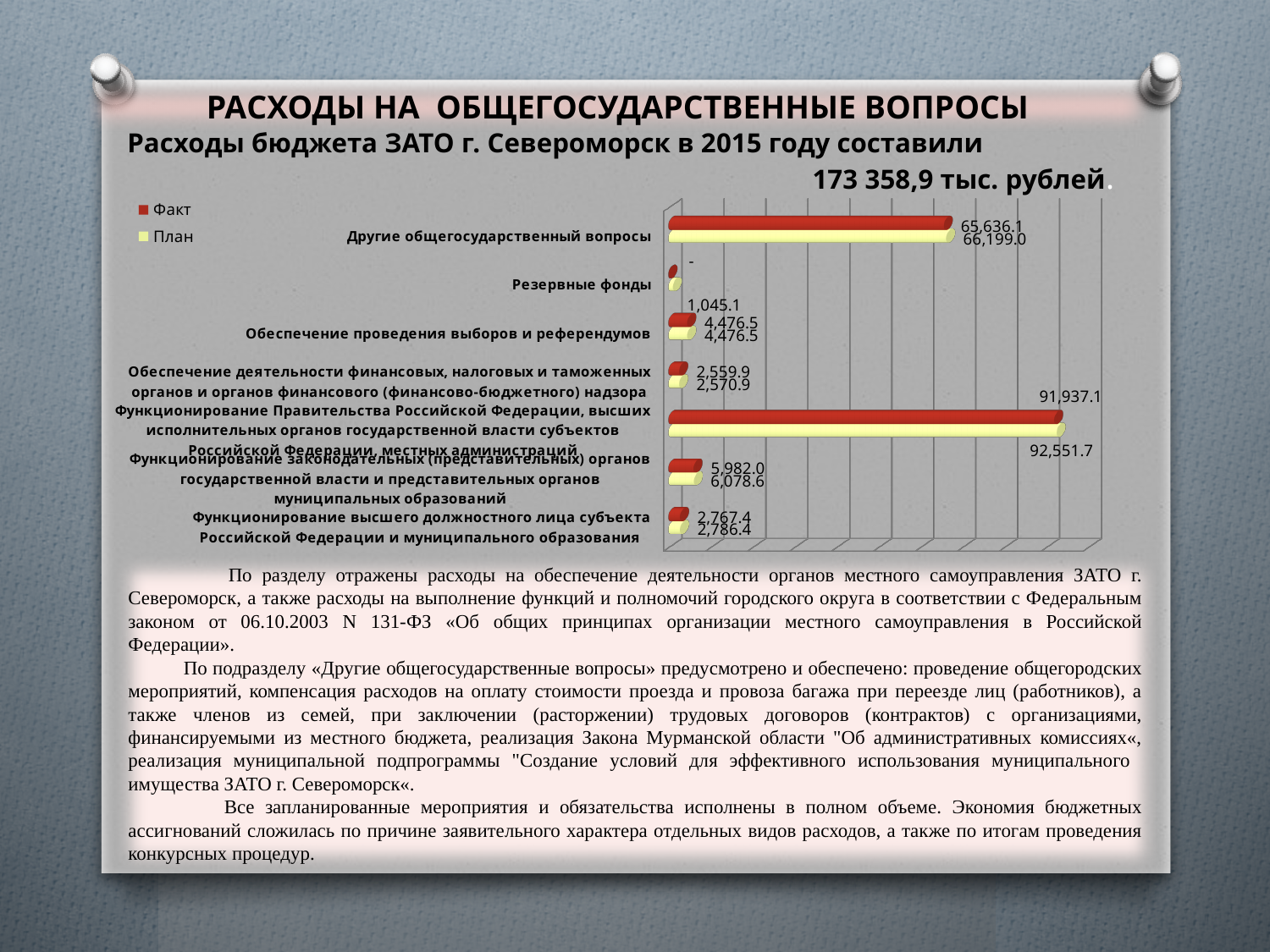
Which category has the highest Факт value? Функционирование Правительства Российской Федерации, высших исполнительных органов государственной власти субъектов Российской Федерации, местных администраций How many series does the chart legend list? 2 What is the Факт value for 'Другие общегосударственный вопросы'? 65,636.1 What are the two series named in the chart legend? Факт and План Which is larger for 'Другие общегосударственный вопросы': the Факт value or the План value? План What is the План value for 'Функционирование законодательных (представительных) органов государственной власти и представительных органов муниципальных образований'? 6,078.6 What is the difference between the План and Факт values for 'Функционирование Правительства Российской Федерации, высших исполнительных органов государственной власти субъектов Российской Федерации, местных администраций'? 614.6 Which category has the lowest План value? Резервные фонды How many categories are shown on the chart? 7 What is the difference between the План and Факт values for 'Функционирование высшего должностного лица субъекта Российской Федерации и муниципального образования'? 19.0 What is the План value for 'Резервные фонды'? 1,045.1 What type of chart is shown on the slide? bar chart